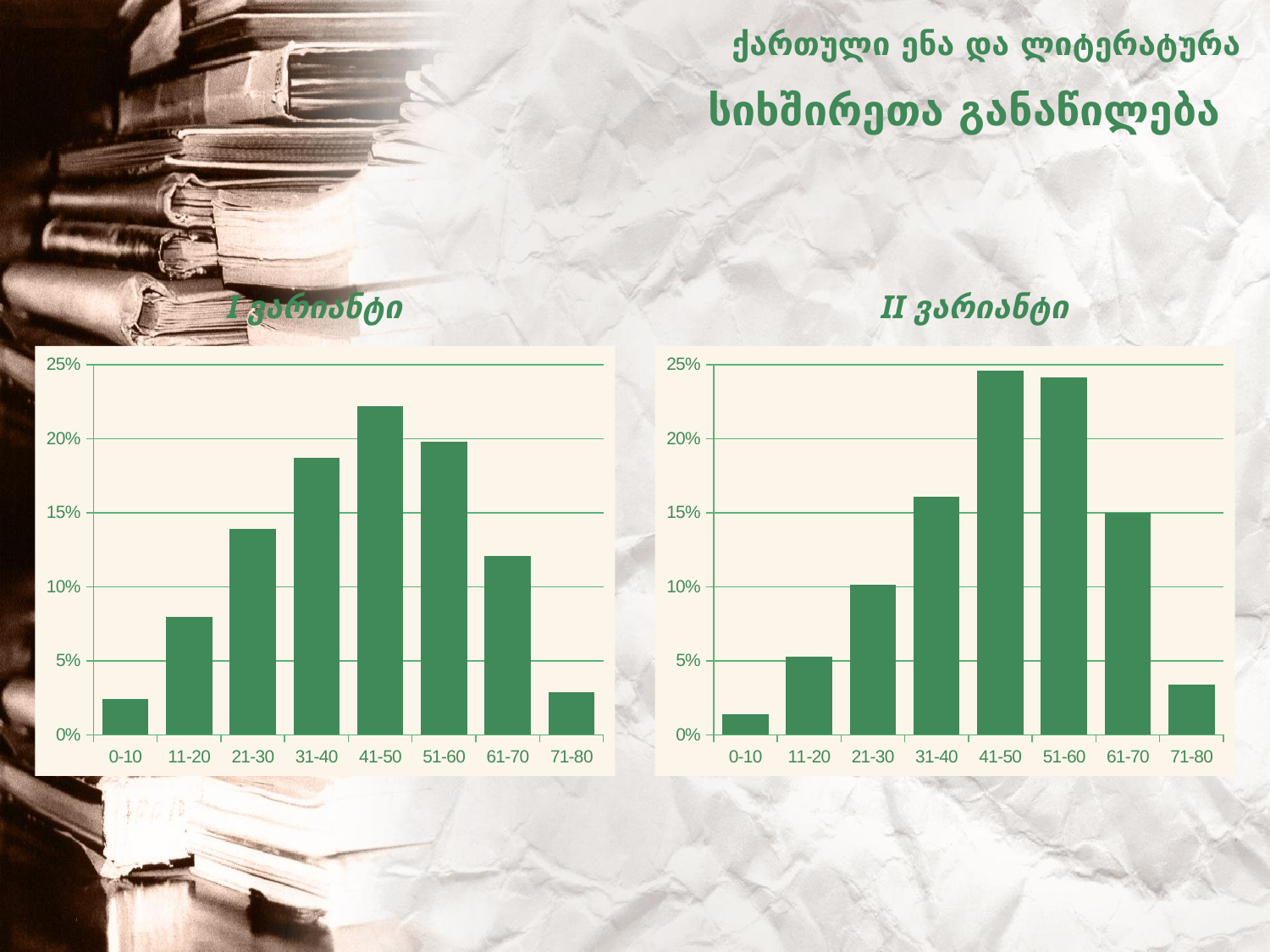
What is the title of the chart on the right side of the slide? II ვარიანტი In the left chart (I ვარიანტი), is the value for 41-50 greater or less than 20%? greater In the right chart (II ვარიანტი), is the value for 71-80 greater or less than 5%? less What kind of chart is the left chart titled "I ვარიანტი"? bar chart In the left chart (I ვარიანტი), which category has the highest value? 41-50 In the right chart (II ვარიანტი), which is larger, the value for 11-20 or the value for 31-40? 31-40 How many categories are shown on the x axis of the right chart titled "II ვარიანტი"? 8 In the left chart (I ვარიანტი), do the values rise or fall from 41-50 to 71-80? fall In the right chart (II ვარიანტი), which category has the lowest value? 0-10 In the left chart (I ვარიანტი), is the value for 11-20 greater or less than 10%? less In the left chart (I ვარიანტი), which is larger, the value for 31-40 or the value for 61-70? 31-40